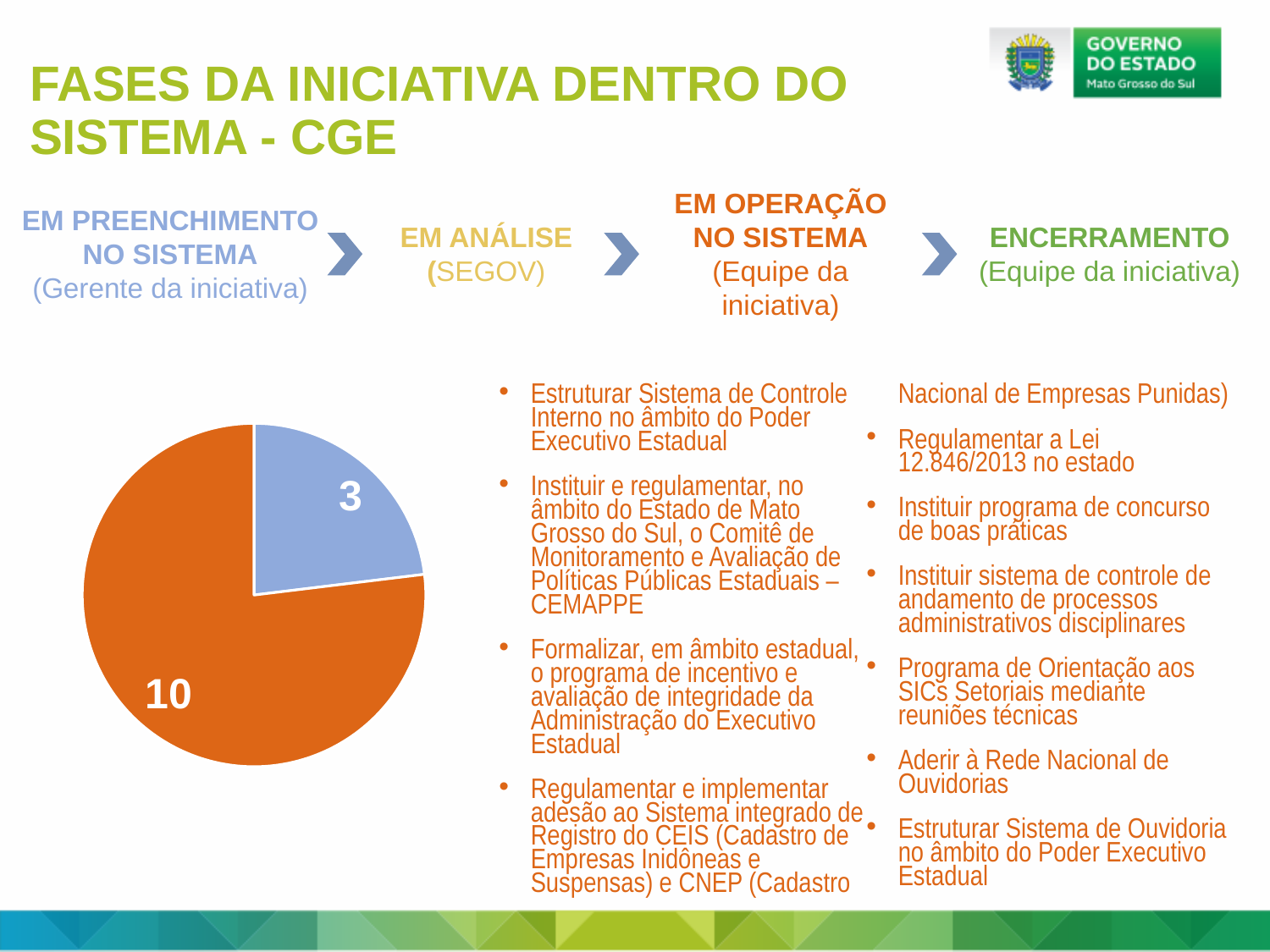
What is the difference between the orange slice value and the blue slice value in the pie chart? 7 What share of the pie chart total does the orange slice represent? 10 out of 13 What is the total of the two values shown in the pie chart? 13 Which two colours are used for the slices of the pie chart? orange and blue What value is printed on the orange slice of the pie chart? 10 What kind of chart is shown on the slide? pie chart Does the pie chart display a legend? No How many slices does the pie chart have? 2 What value is printed on the blue slice of the pie chart? 3 Which slice of the pie chart is the smallest? the blue slice (3) Is the orange slice or the blue slice of the pie chart larger? the orange slice Which slice of the pie chart is the largest? the orange slice (10)